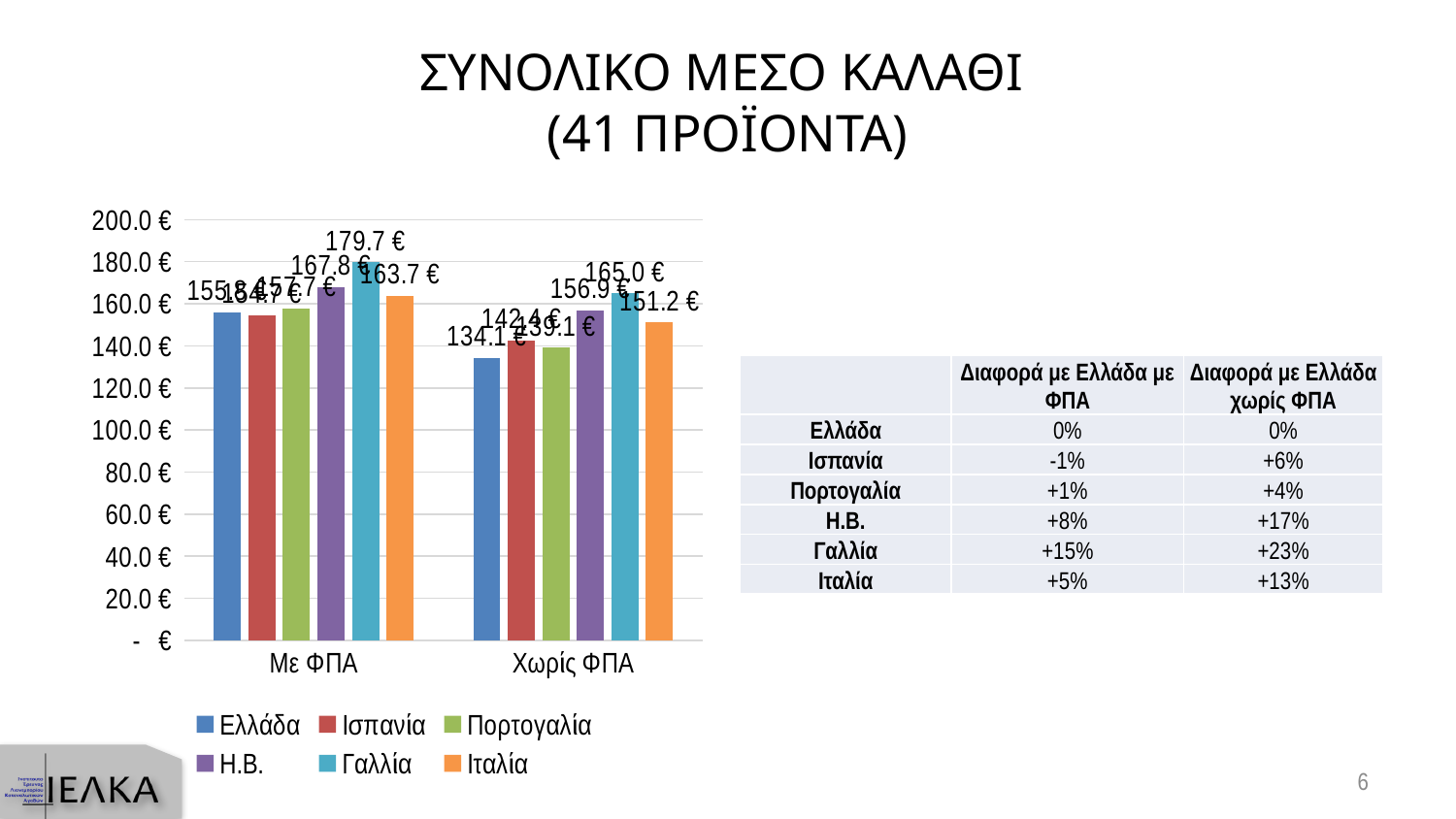
What is the value for Η.Β. in the Χωρίς ΦΠΑ category? 156.9 € What is the value for Ελλάδα in the Χωρίς ΦΠΑ category? 134.1 € What is the value for Γαλλία in the Χωρίς ΦΠΑ category? 165.0 € Which country has the highest value in the Με ΦΠΑ category? Γαλλία In the Χωρίς ΦΠΑ category, which is larger: the value for Η.Β. or the value for Ιταλία? Η.Β. How many series does the chart legend list? 6 What kind of chart is shown on the slide? bar chart What is the difference between the Με ΦΠΑ and Χωρίς ΦΠΑ values for Γαλλία? 14.7 € How many categories are shown on the x axis of the chart? 2 What is the value for Ιταλία in the Με ΦΠΑ category? 163.7 € What is the value for Γαλλία in the Με ΦΠΑ category? 179.7 € Which country has the lowest value in the Χωρίς ΦΠΑ category? Ελλάδα